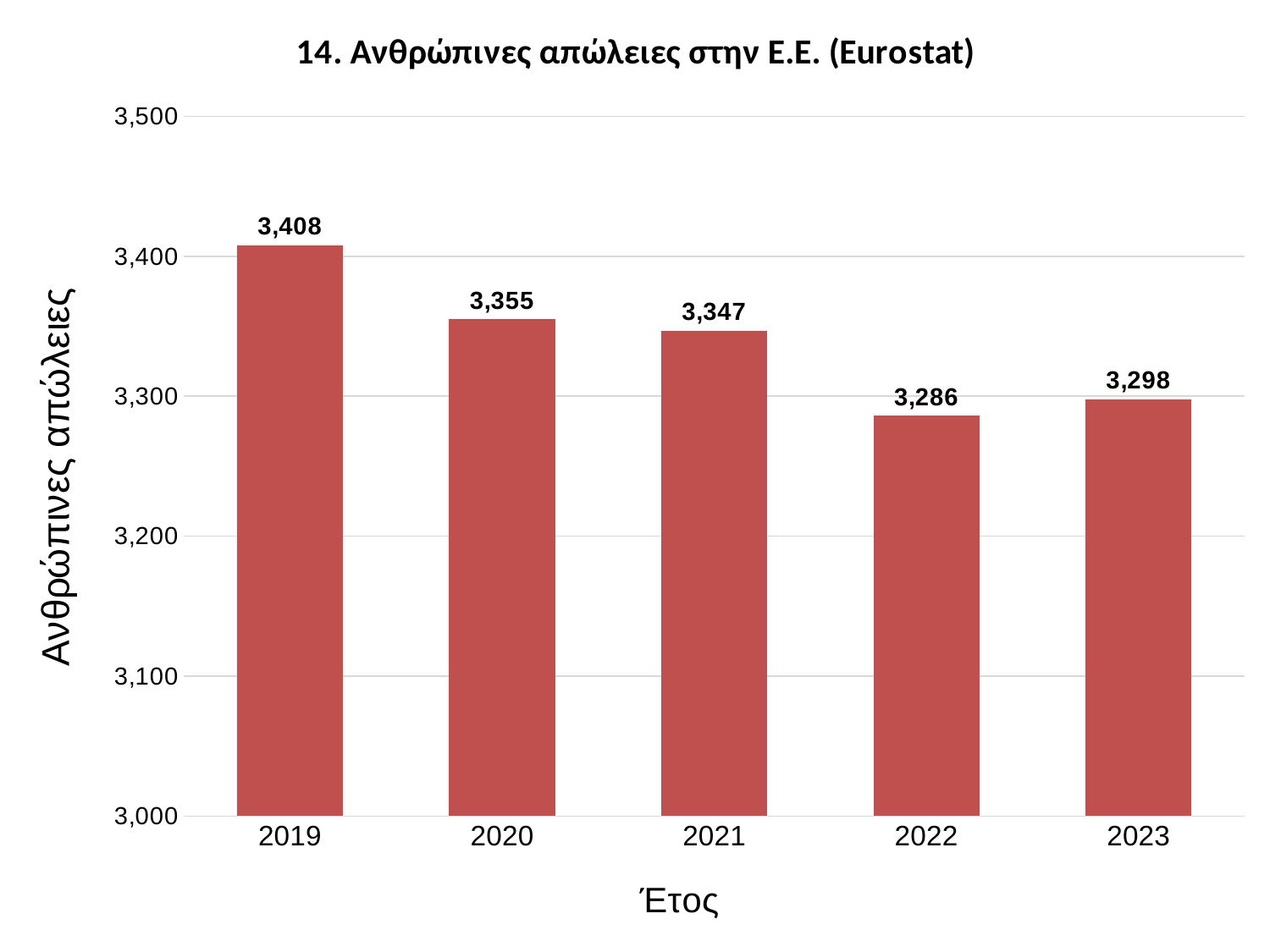
Which year has the highest value? 2019 What is the value for 2022? 3,286 What is the difference between the values for 2019 and 2020? 53 What is the difference between the values for 2023 and 2022? 12 Is the value for 2021 greater or less than 3,300? greater What is the value for 2019? 3,408 How many years are shown on the x axis? 5 What is the value for 2023? 3,298 What is the title of the chart? 14. Ανθρώπινες απώλειες στην Ε.Ε. (Eurostat) Which is larger, the value for 2020 or the value for 2021? 2020 What kind of chart is this? bar chart Which year has the lowest value? 2022